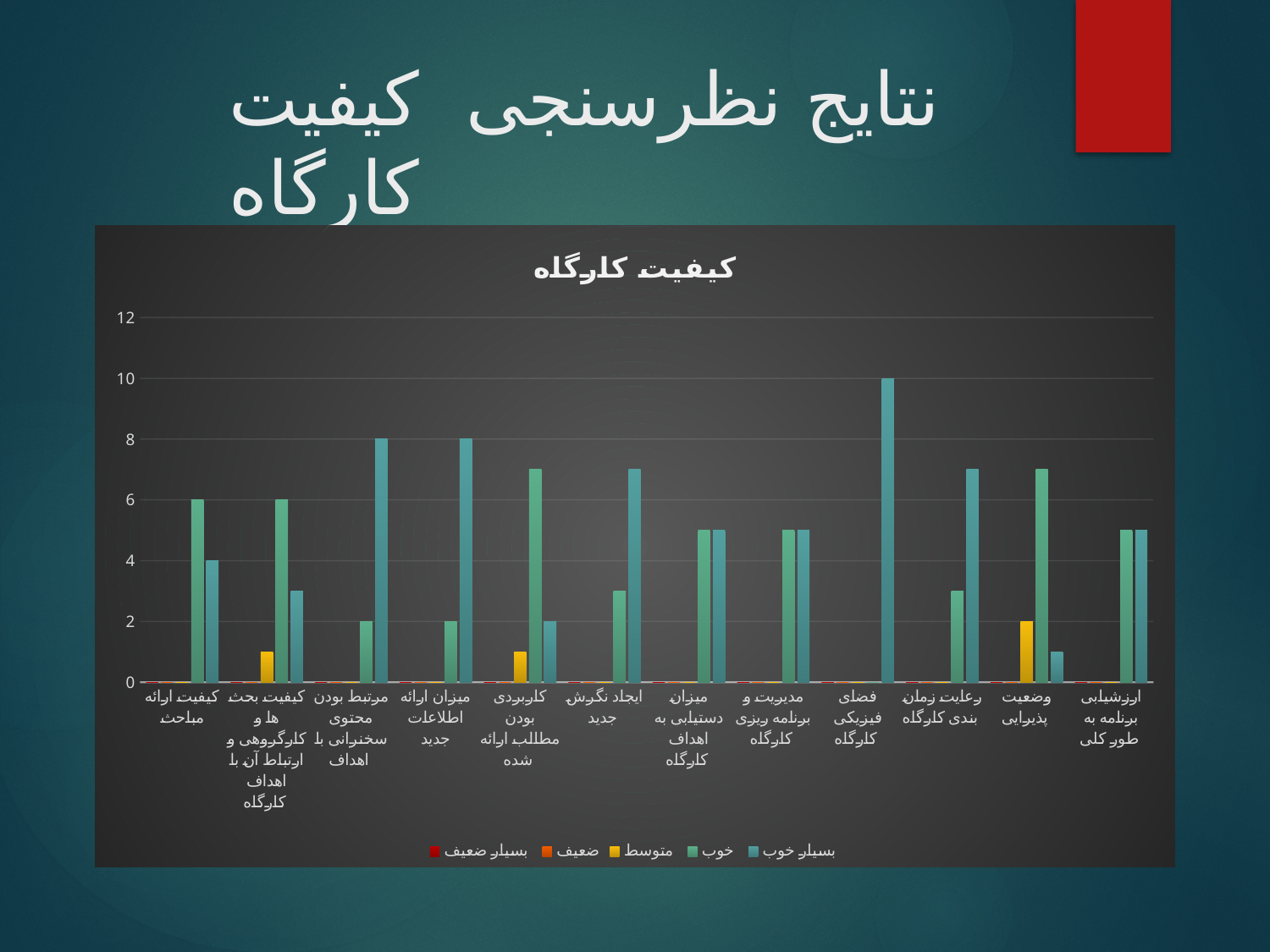
Is the value of بسیار خوب for وضعیت پذیرایی greater or less than 2? less What is the value of بسیار خوب for فضای فیزیکی کارگاه? 10 What is the title of the chart? کیفیت کارگاه How many series does the legend list? 5 What is the value of خوب for کیفیت ارائه مباحث? 6 For ایجاد نگرش جدید, which is larger: خوب or بسیار خوب? بسیار خوب Which category has the tallest bar in the chart? فضای فیزیکی کارگاه What kind of chart is shown on the slide? Bar chart What is the value of بسیار خوب for میزان ارائه اطلاعات جدید? 8 What is the difference between the بسیار خوب value for فضای فیزیکی کارگاه and the بسیار خوب value for میزان ارائه اطلاعات جدید? 2 Is the value of خوب for کاربردی بودن مطالب ارائه شده greater or less than 6? greater How many categories are shown along the x axis? 12